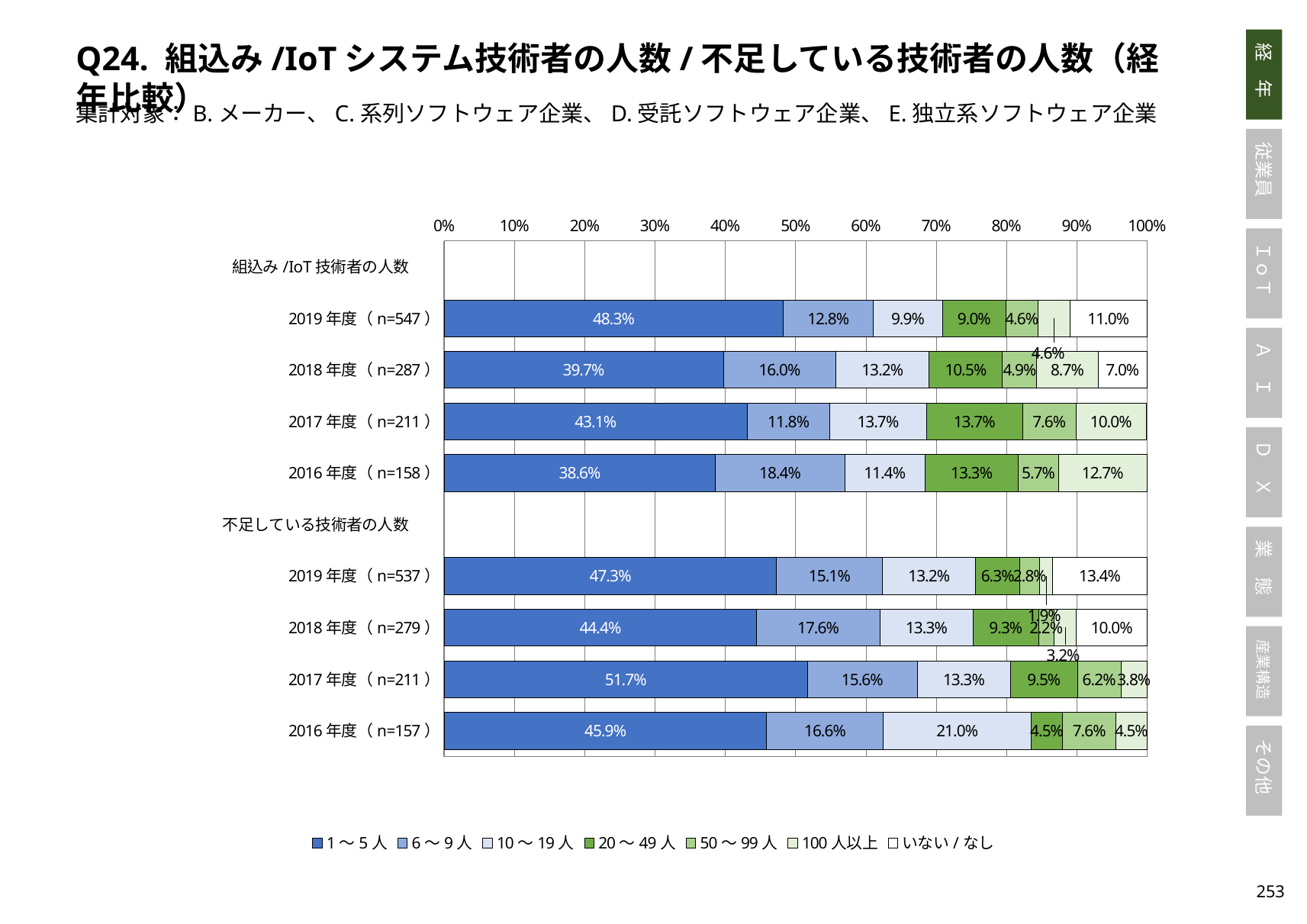
How many year rows (bars) are plotted in the chart? 8 What is the value of the 1〜5人 segment for 2019年度 (n=547) under 組込み/IoT技術者の人数? 48.3% What is the first entry in the legend? 1〜5人 Which row has the smallest 1〜5人 segment? 2016年度 (n=158) under 組込み/IoT技術者の人数 What kind of chart is shown on the slide? Stacked bar chart How many series does the legend list? 7 Under 組込み/IoT技術者の人数, which has the larger 6〜9人 value: 2016年度 (n=158) or 2019年度 (n=547)? 2016年度 (n=158) Under 組込み/IoT技術者の人数, what is the difference between the 1〜5人 values for 2019年度 (n=547) and 2018年度 (n=287)? 8.6 percentage points What is the value of the 10〜19人 segment for 2016年度 (n=157) under 不足している技術者の人数? 21.0% What is the value of the 1〜5人 segment for 2017年度 (n=211) under 不足している技術者の人数? 51.7% Which row has the largest 1〜5人 segment? 2017年度 (n=211) under 不足している技術者の人数 What is the value of the いない/なし segment for 2019年度 (n=547) under 組込み/IoT技術者の人数? 11.0%